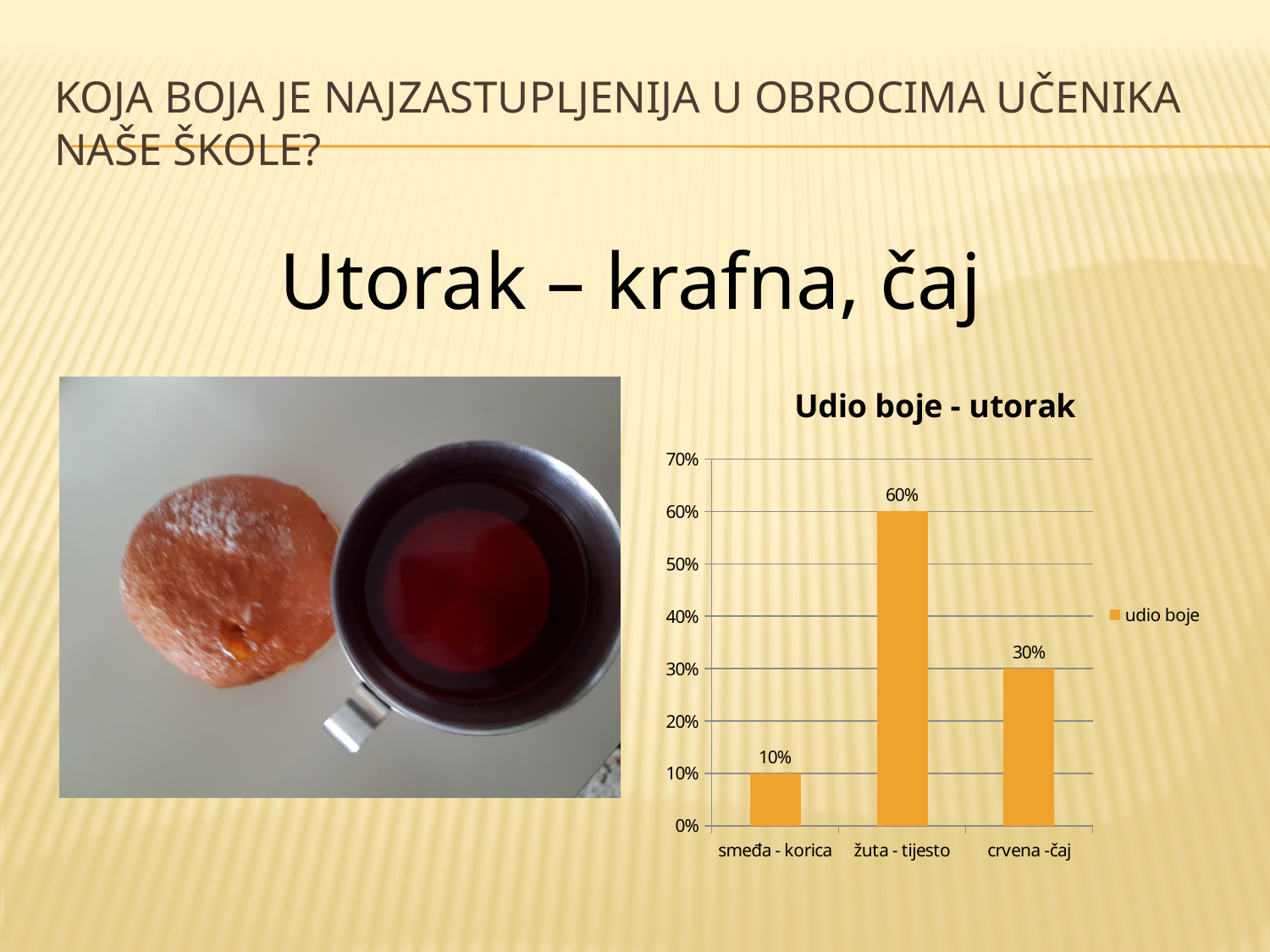
How many series does the legend list? 1 What is the value for žuta - tijesto? 60% Which category has the lowest value? smeđa - korica Is the value for žuta - tijesto greater or less than 50%? greater Which category has the highest value? žuta - tijesto What kind of chart is shown? bar chart How many categories are shown on the x axis? 3 What is the value for crvena -čaj? 30% What is the difference between the values for žuta - tijesto and crvena -čaj? 30% Which is larger, the value for crvena -čaj or the value for smeđa - korica? crvena -čaj What is the value for smeđa - korica? 10% What is the title of the chart? Udio boje - utorak